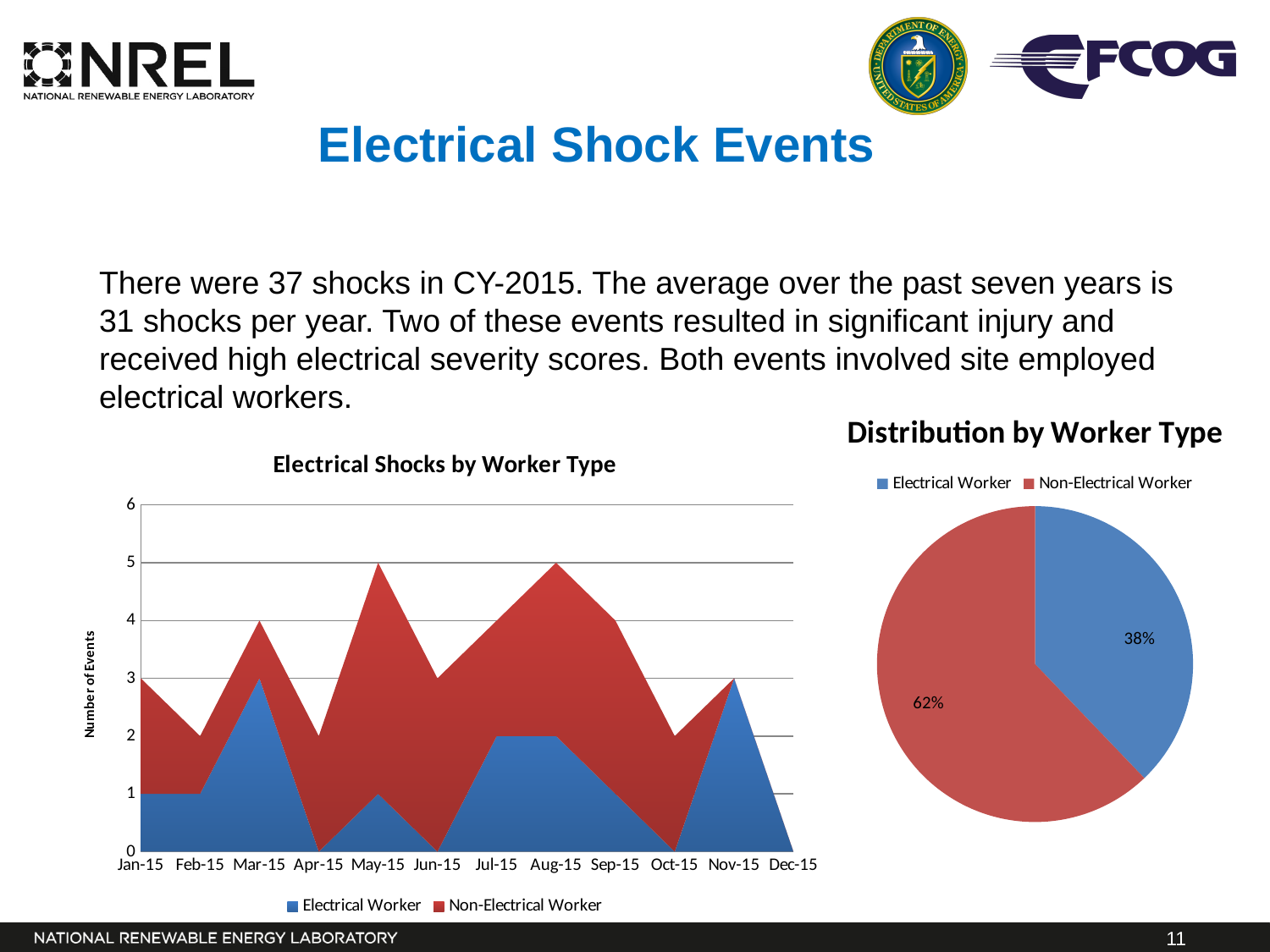
How many series does the legend of the 'Electrical Shocks by Worker Type' chart list? 2 On the pie chart 'Distribution by Worker Type', what share is Electrical Worker? 38% What is the y-axis label of the 'Electrical Shocks by Worker Type' chart? Number of Events On the pie chart 'Distribution by Worker Type', how many percentage points larger is the Non-Electrical Worker share than the Electrical Worker share? 24 percentage points On the 'Electrical Shocks by Worker Type' chart, what is the Electrical Worker value for Mar-15? 3 On the 'Electrical Shocks by Worker Type' chart, is the total number of events in Aug-15 greater or less than 4? greater On the pie chart 'Distribution by Worker Type', what share is Non-Electrical Worker? 62% On the pie chart 'Distribution by Worker Type', which worker type has the larger share? Non-Electrical Worker On the 'Electrical Shocks by Worker Type' chart, what is the total number of events (both worker types combined) in May-15? 5 On the 'Electrical Shocks by Worker Type' chart, what is the Electrical Worker value for Nov-15? 3 How many months are shown on the x axis of the 'Electrical Shocks by Worker Type' chart? 12 What kind of chart is 'Electrical Shocks by Worker Type'? Stacked area chart